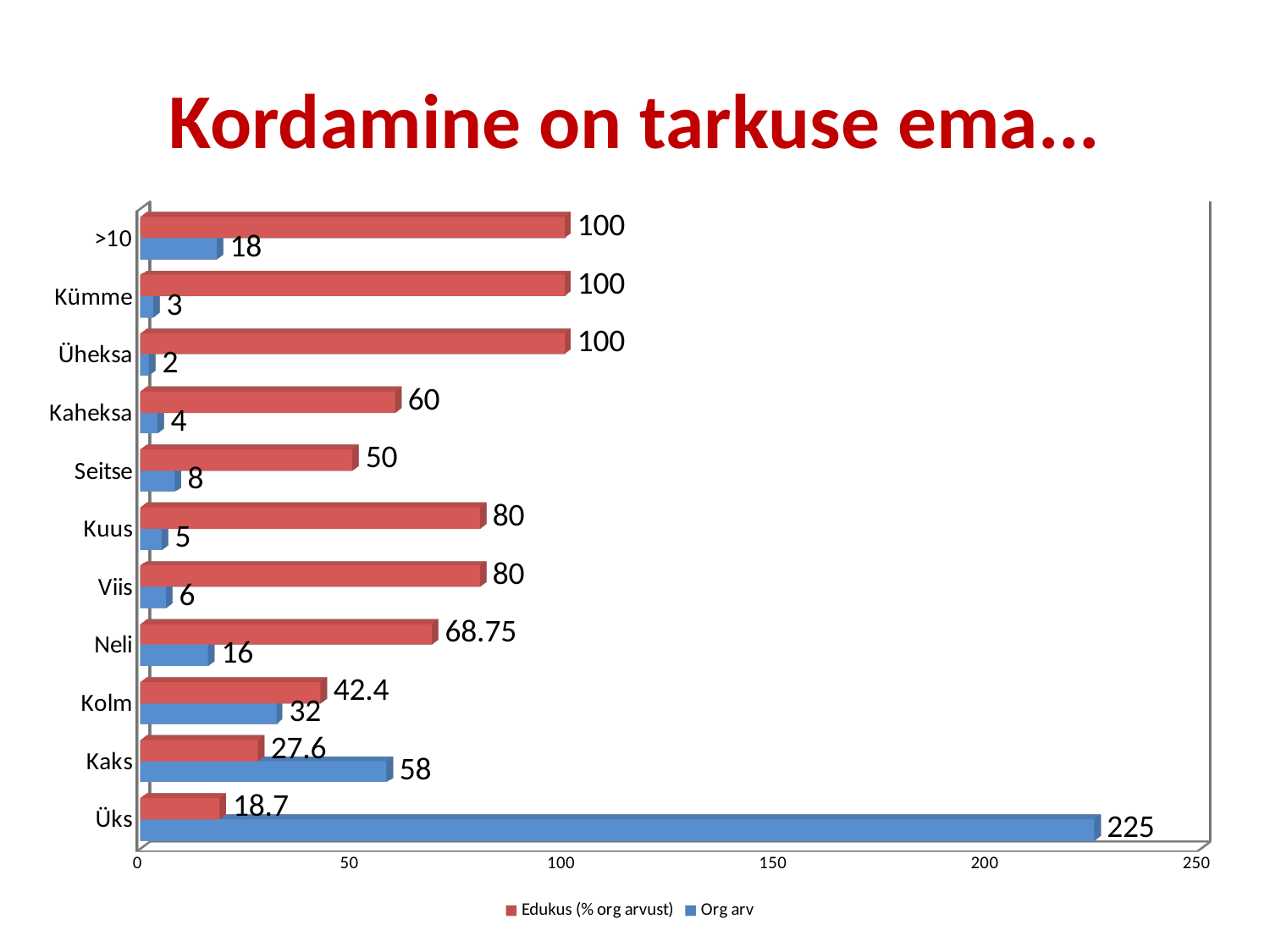
Which is larger, the Edukus (% org arvust) value for Kaheksa or for Seitse? Kaheksa What is the difference between the Org arv values for Kaks and Kolm? 26 Which category has the lowest Org arv value? Üheksa What is the Org arv value for Kolm? 32 What kind of chart is shown on the slide? bar chart What is the Org arv value for Üks? 225 What is the Edukus (% org arvust) value for Kaks? 27.6 What is the Edukus (% org arvust) value for Neli? 68.75 How many categories are shown on the chart? 11 Is the Org arv value for Üks greater or less than 200? greater How many series does the legend list? 2 Which category has the highest Org arv value? Üks